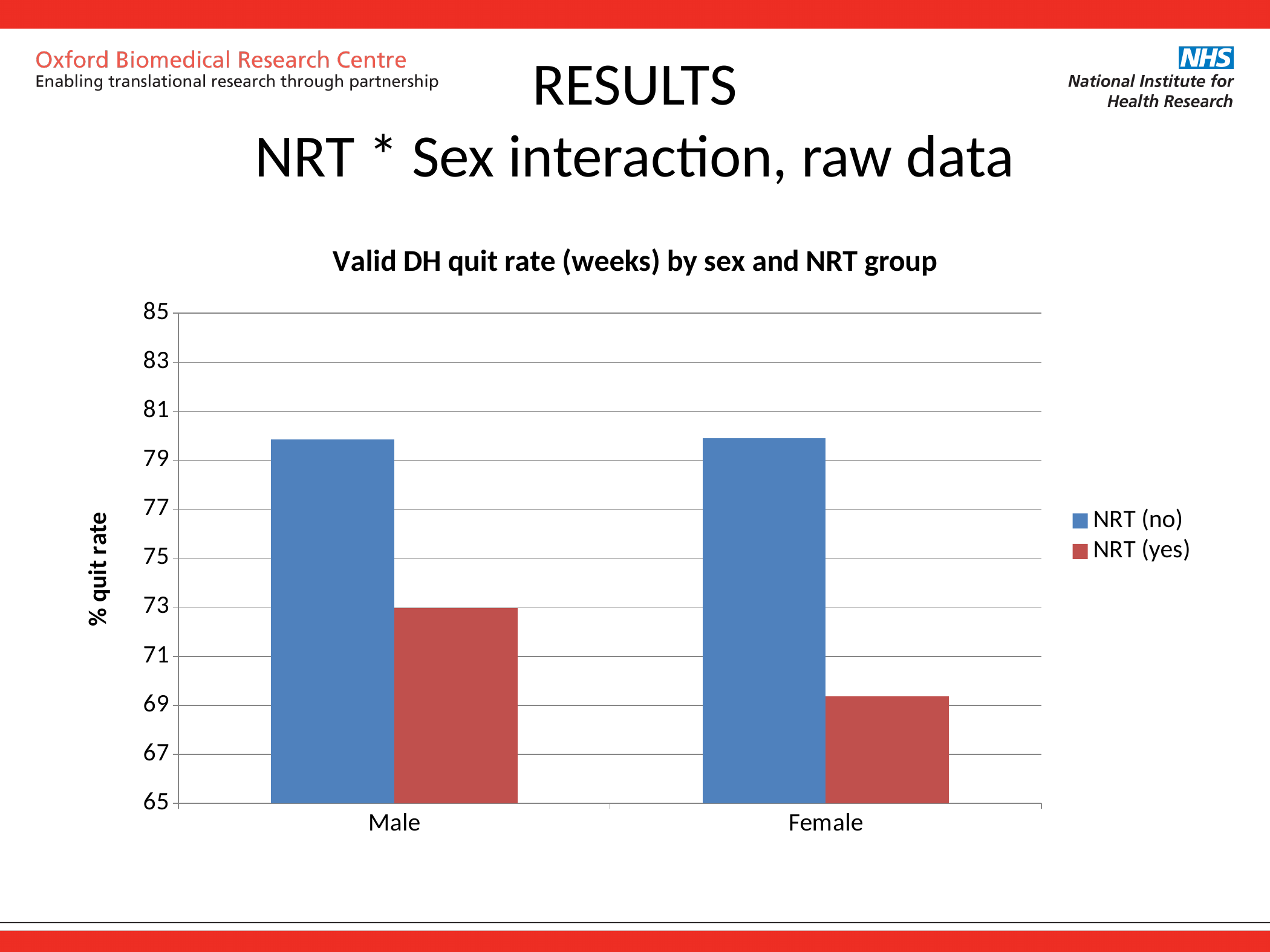
Is the value for Male NRT (yes) greater or less than 75? less Is the value for Male NRT (no) greater or less than 79? greater How many series does the legend list? 2 Which bar is the lowest in the chart? Female, NRT (yes) Is the value for Female NRT (no) greater or less than 81? less What type of chart is shown on the slide? bar chart For NRT (yes), which is larger: Male or Female? Male What is the title of the chart? Valid DH quit rate (weeks) by sex and NRT group For Male, which is larger: NRT (no) or NRT (yes)? NRT (no) What is the label of the y axis? % quit rate How many categories are shown on the x axis? 2